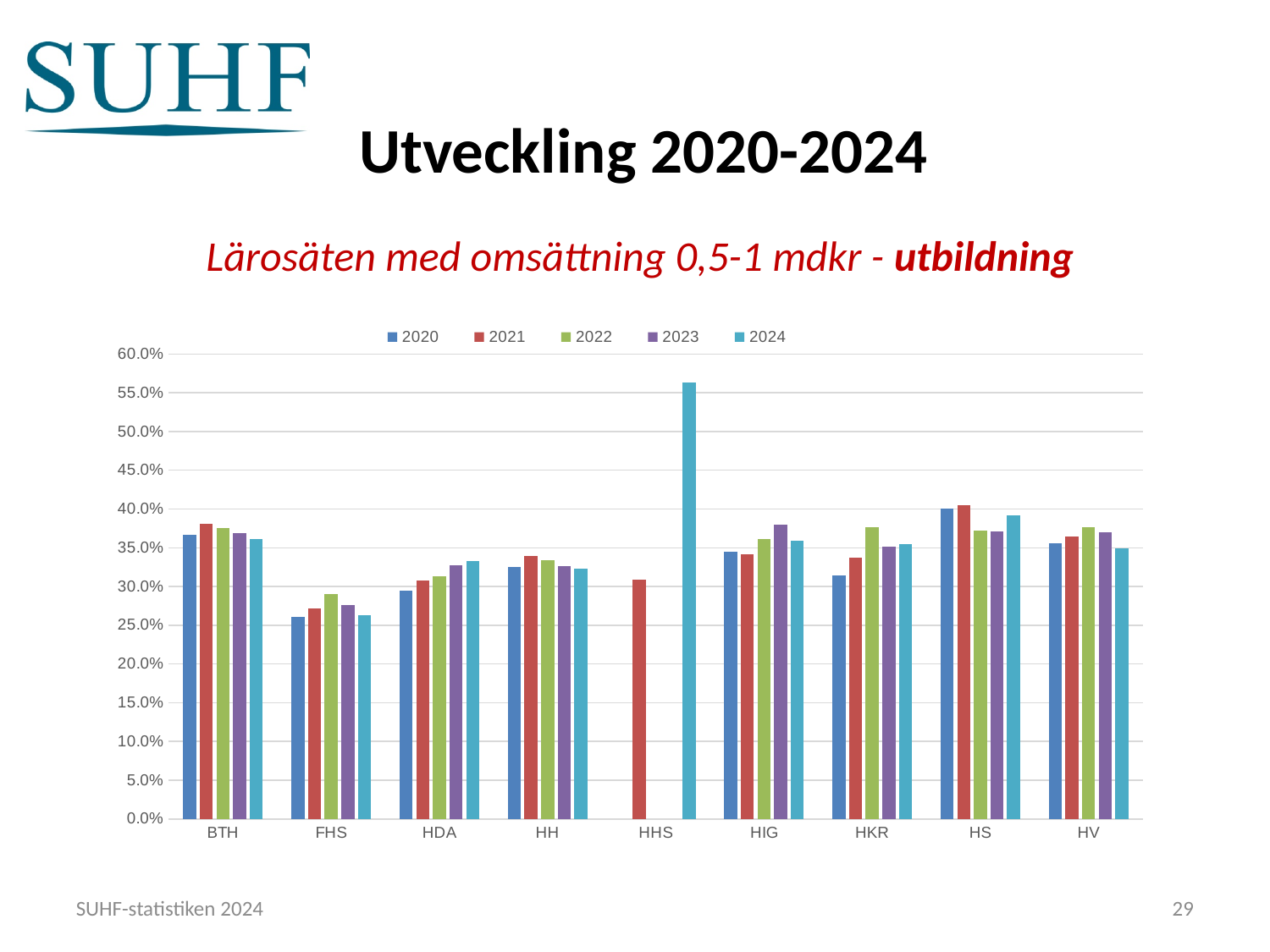
How many categories (lärosäten) are shown on the x axis? 9 Which category has the lowest values overall in the chart? FHS Which category has the tallest bar in the chart? HHS For HKR, which year has the highest value? 2022 Is the 2020 value for FHS greater or less than 30.0%? less For HIG, which year has the highest value? 2023 How many series does the legend list? 5 Is the 2020 value for HKR greater or less than 35.0%? less Do the values for HDA rise or fall from 2020 to 2024? rise What kind of chart is shown on the slide? bar chart Which is larger for FHS: the 2022 value or the 2020 value? 2022 Is the 2024 value for HHS greater or less than 50.0%? greater